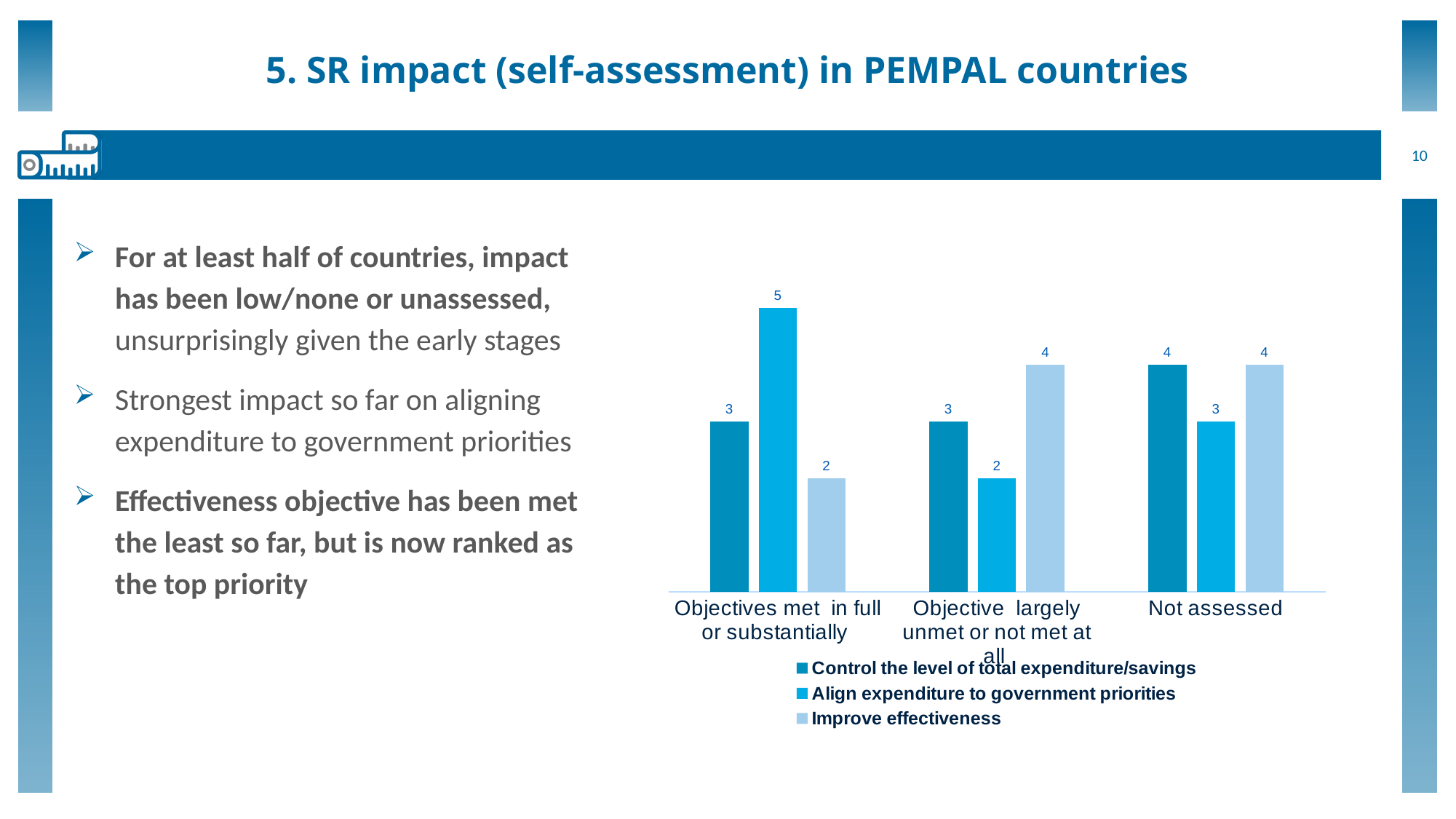
What kind of chart is shown on the slide? Bar chart Which series is shown in the lightest blue colour in the chart? Improve effectiveness What is the value for 'Align expenditure to government priorities' in the 'Objectives met in full or substantially' category? 5 What is the value for 'Improve effectiveness' in the 'Objective largely unmet or not met at all' category? 4 In the 'Not assessed' category, which is larger: 'Control the level of total expenditure/savings' or 'Align expenditure to government priorities'? Control the level of total expenditure/savings How many categories are shown on the x axis of the chart? 3 Which category has the highest value for 'Align expenditure to government priorities'? Objectives met in full or substantially What is the value for 'Improve effectiveness' in the 'Objectives met in full or substantially' category? 2 What is the difference between 'Align expenditure to government priorities' and 'Improve effectiveness' in the 'Objectives met in full or substantially' category? 3 Which category has the lowest value for 'Improve effectiveness'? Objectives met in full or substantially How many series does the chart legend list? 3 What is the value for 'Control the level of total expenditure/savings' in the 'Not assessed' category? 4